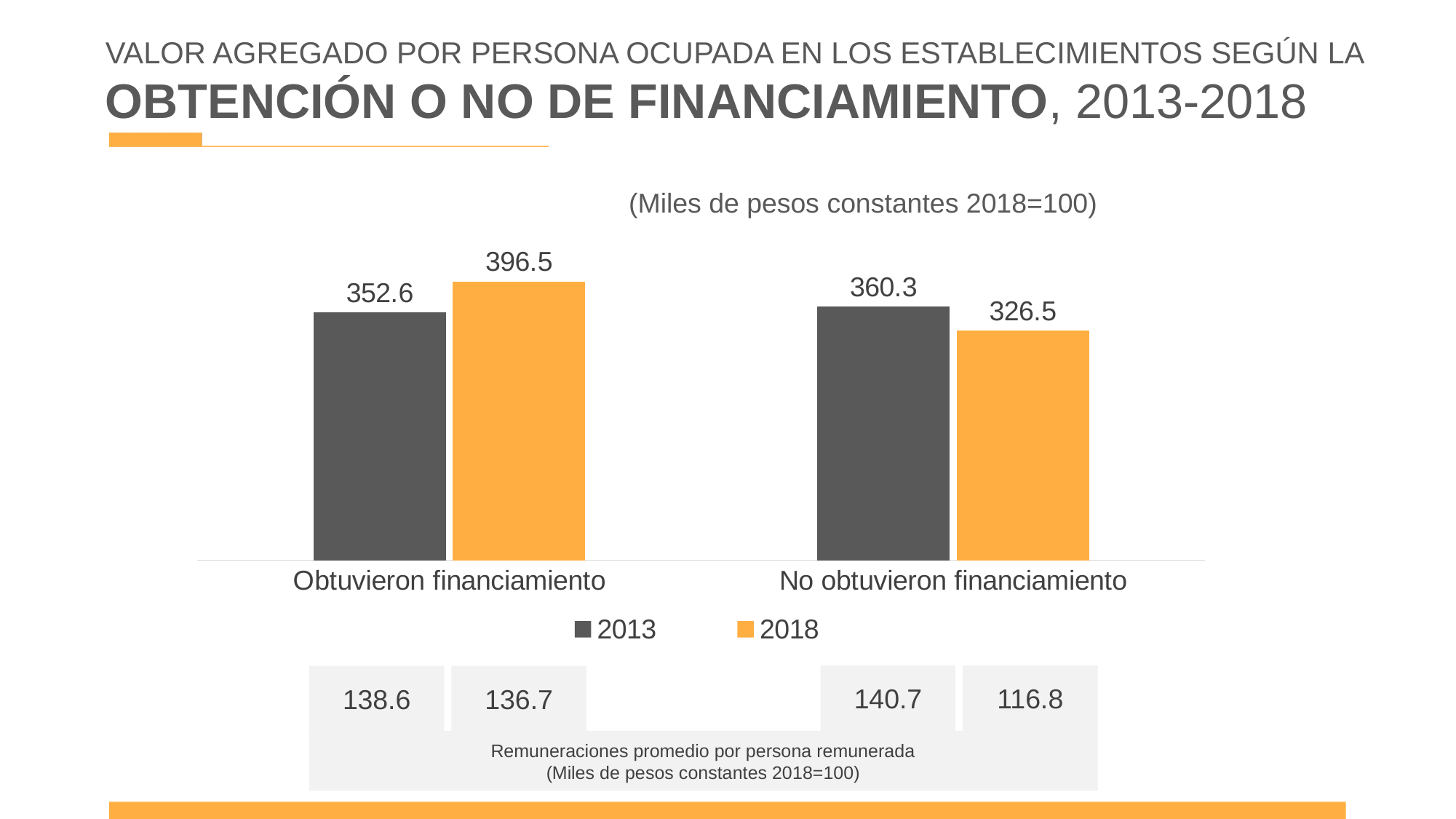
What is the 2013 value for "Obtuvieron financiamiento"? 352.6 How many categories are shown on the x axis? 2 Which bar has the highest value on the chart? 2018, Obtuvieron financiamiento What is the difference between the 2018 and 2013 values for "Obtuvieron financiamiento"? 43.9 Which is larger: the 2013 value for "Obtuvieron financiamiento" or the 2013 value for "No obtuvieron financiamiento"? No obtuvieron financiamiento What is the 2018 value for "Obtuvieron financiamiento"? 396.5 What is the difference between the 2013 and 2018 values for "No obtuvieron financiamiento"? 33.8 Which bar has the lowest value on the chart? 2018, No obtuvieron financiamiento What kind of chart is shown on the slide? Bar chart What is the 2013 value for "No obtuvieron financiamiento"? 360.3 What is the 2018 value for "No obtuvieron financiamiento"? 326.5 How many series does the legend list? 2